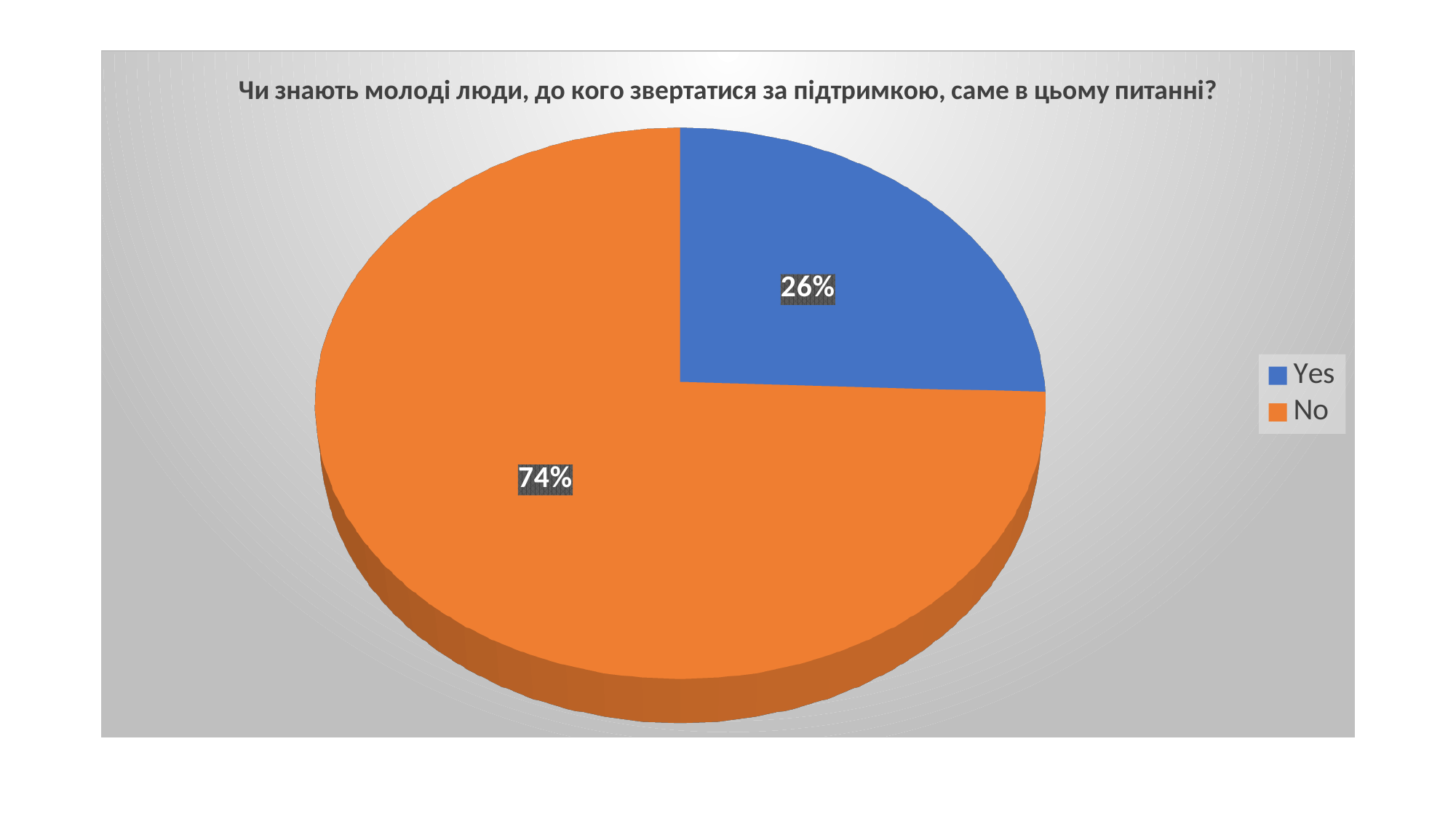
Which is larger, the "Yes" slice or the "No" slice? No What share of the pie does the "No" slice represent? 74% Which slice is the largest? No What is the difference in percentage points between the "No" and "Yes" slices? 48 How many slices does the pie chart have? 2 What share of the pie does the "Yes" slice represent? 26% What colour is the "Yes" slice? blue What colour is the "No" slice? orange How many entries does the legend list? 2 What kind of chart is shown on the slide? pie chart Which slice is the smallest? Yes